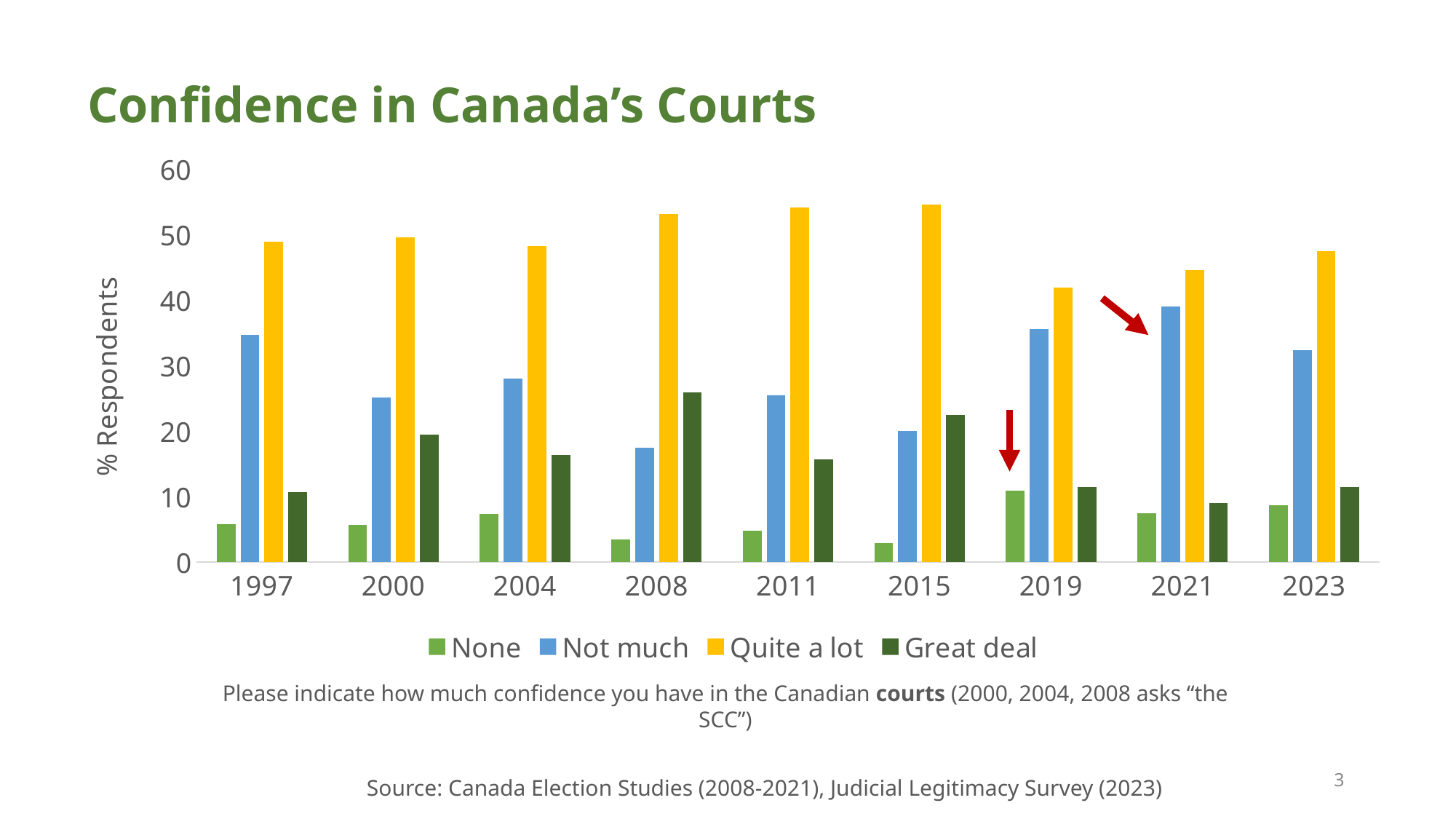
Does the 'None' value rise or fall from 2015 to 2019? rise In which year is the 'Not much' bar highest? 2021 In which year is the 'Great deal' bar highest? 2008 What is the label on the y axis? % Respondents Is the 'Quite a lot' value for 2008 greater or less than 50? greater What kind of chart is shown on the slide? bar chart Is the 'Not much' value for 2008 greater or less than 20? less Is the 'Not much' value for 1997 greater or less than 30? greater How many years are shown along the x axis? 9 In 2019, which is larger: the 'Not much' bar or the 'Quite a lot' bar? Quite a lot In which year is the 'Quite a lot' bar lowest? 2019 How many series does the legend list? 4